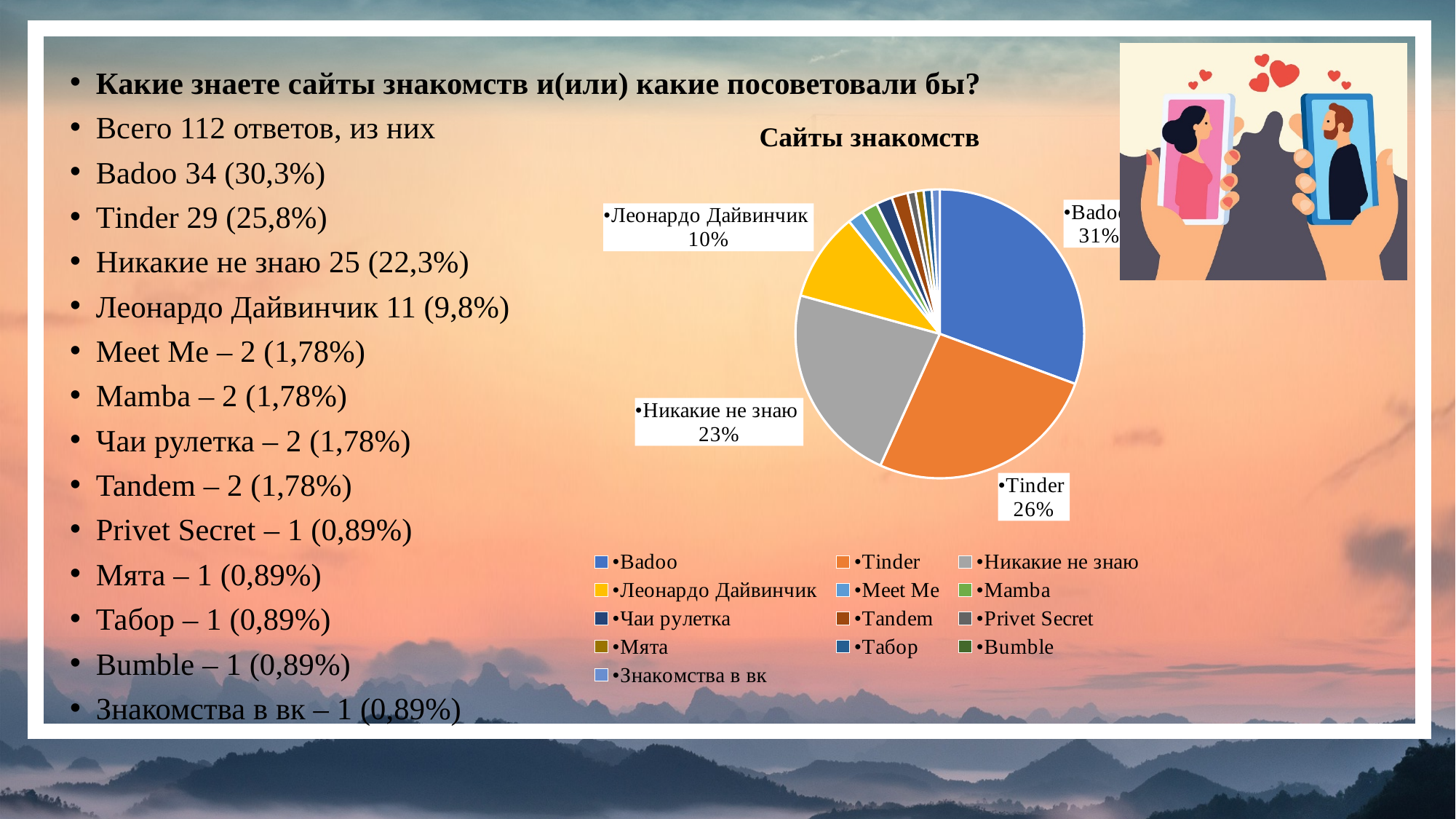
What is the title of the chart? Сайты знакомств What colour is the Tinder slice in the pie chart? Orange What share of the pie does Tinder have? 26% What is the difference in percentage points between the Tinder slice and the "Леонардо Дайвинчик" slice? 16 percentage points Which slice is larger, Tinder or "Никакие не знаю"? Tinder What kind of chart is shown on the slide? Pie chart What share of the pie does Badoo have? 31% Which category has the largest slice of the pie? Badoo How many categories does the chart legend list? 13 What share of the pie does "Леонардо Дайвинчик" have? 10% What share of the pie does "Никакие не знаю" have? 23% What is the difference in percentage points between the Badoo slice and the Tinder slice? 5 percentage points